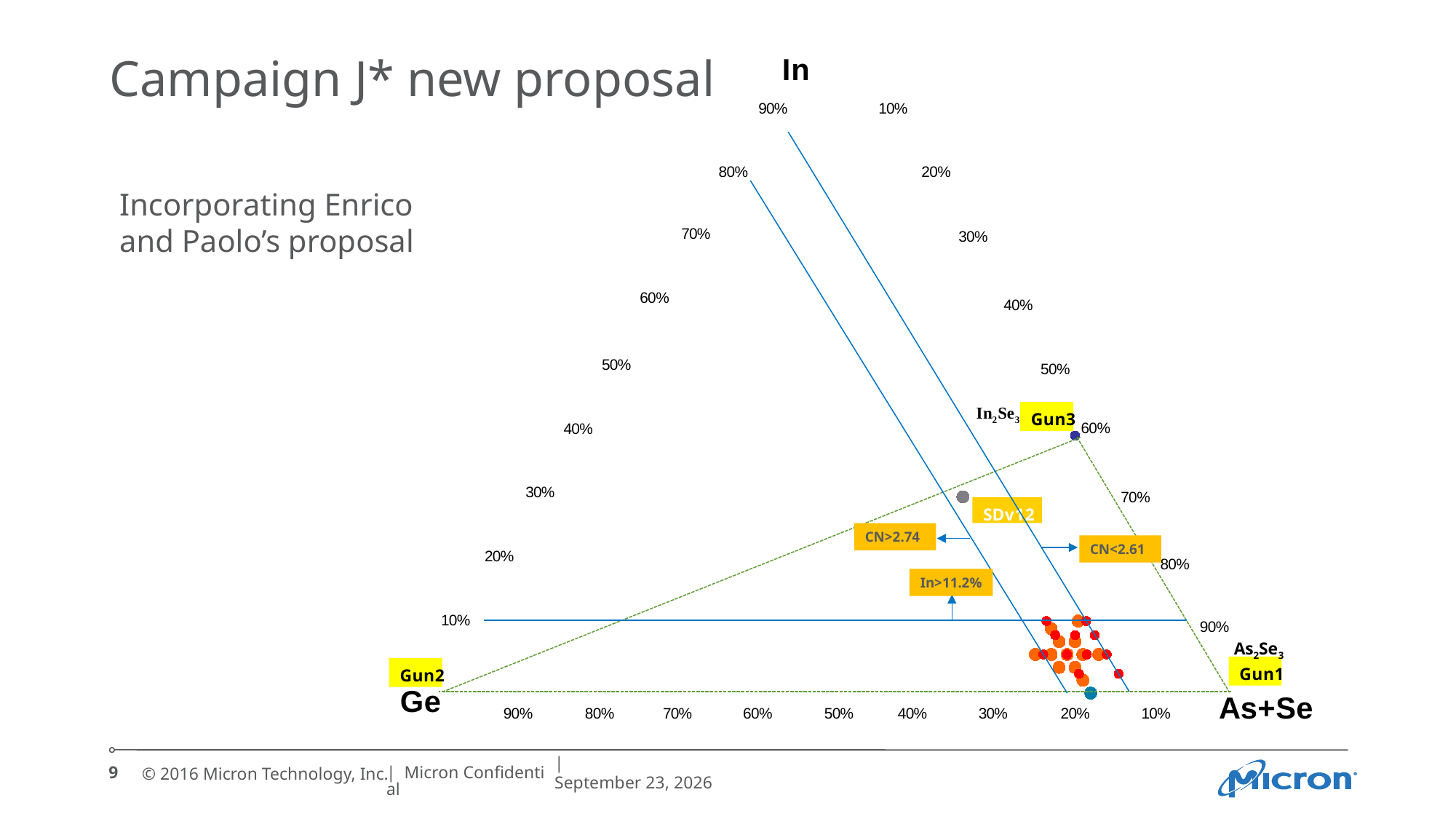
How many gun positions are labelled on the diagram? 3 What CN condition is written in the orange box on the left of the two diagonal lines? CN>2.74 What are the three vertex labels of the ternary diagram? In, Ge, As+Se Is the In content of the grey SDv12 point greater or less than 10%? greater Which gun label is placed at the As+Se vertex of the diagram? Gun1 Which gun label is placed at the Ge vertex of the diagram? Gun2 Is the In content of the grey SDv12 point greater or less than 50%? less What kind of chart is shown on the slide? Ternary (triangular) diagram Which compound is labelled next to Gun1? As2Se3 What CN condition is written in the orange box on the right of the two diagonal lines? CN<2.61 Which compound is labelled next to Gun3? In2Se3 What In threshold is written in the orange box above the horizontal line? In>11.2%